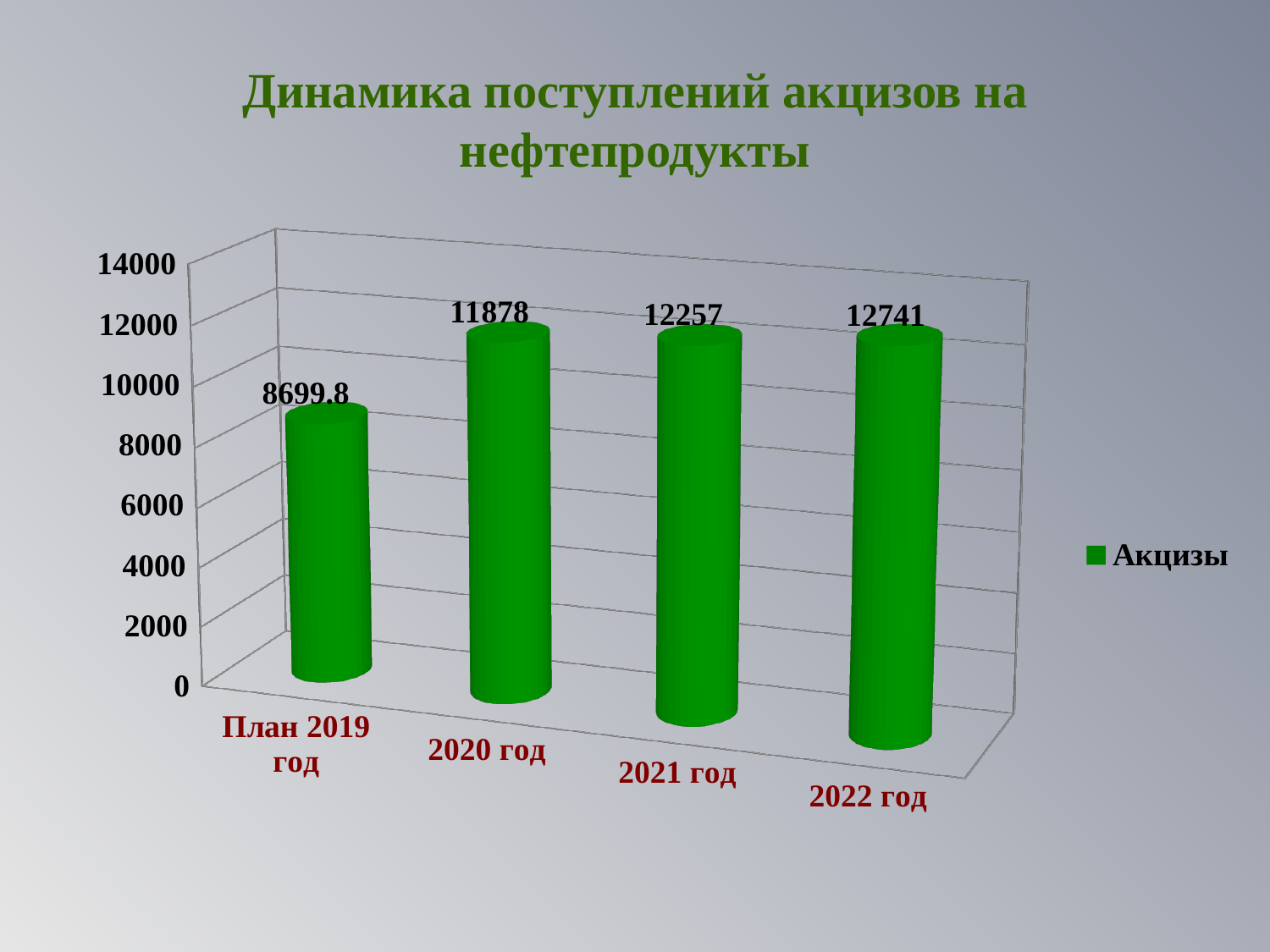
Which category has the highest value? 2022 год Do the values rise or fall from left to right along the x axis? rise What is the value for 2022 год? 12741 What is the difference between the values for 2020 год and План 2019 год? 3178.2 What is the value for 2021 год? 12257 What is the value for План 2019 год? 8699.8 What is the value for 2020 год? 11878 How many categories are shown on the x axis? 4 What is the difference between the values for 2022 год and 2021 год? 484 Which is larger, the value for 2020 год or the value for 2021 год? 2021 год Which category has the lowest value? План 2019 год What kind of chart is shown? bar chart